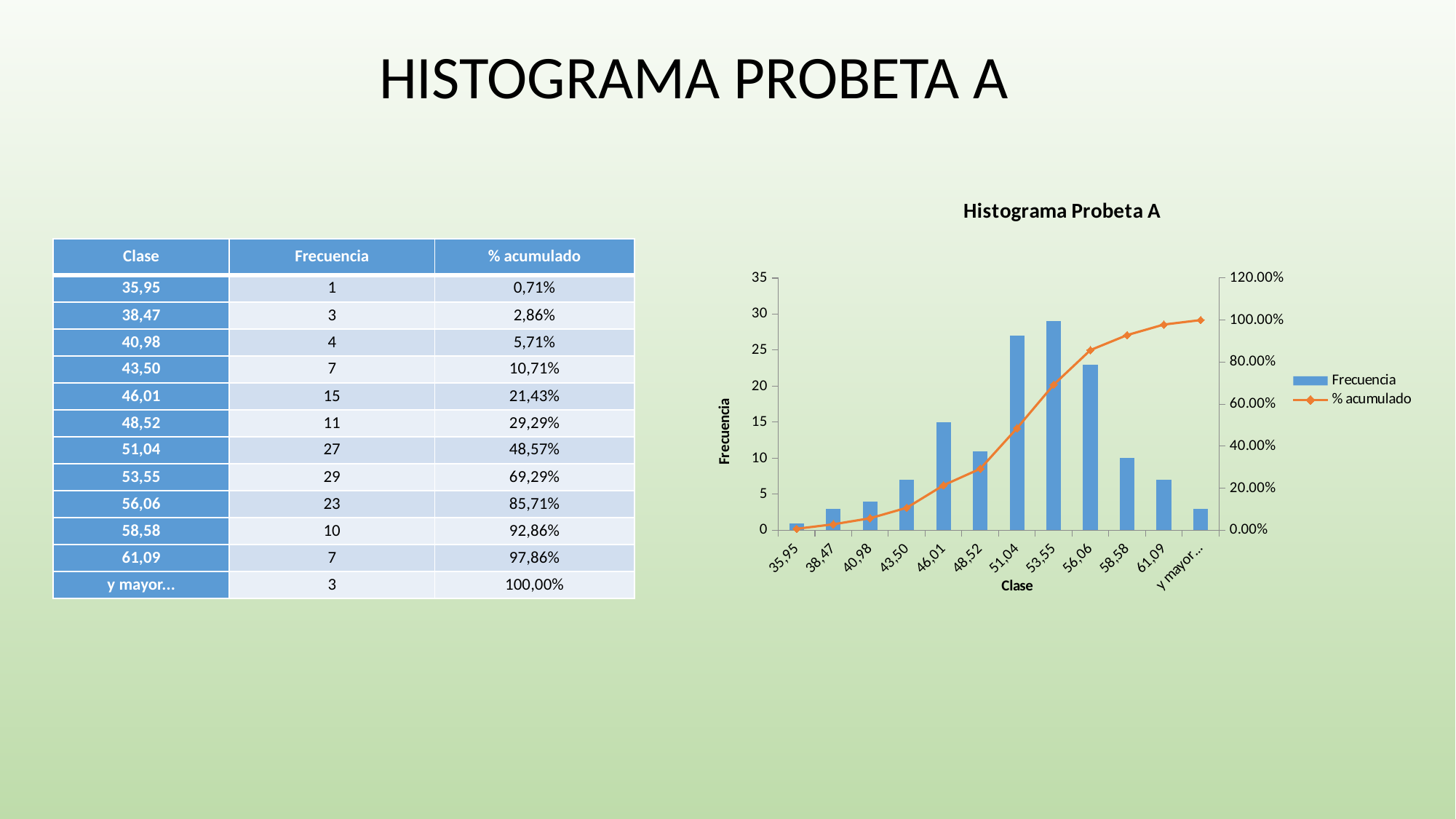
Does the % acumulado line rise or fall from left to right along the x axis? rises What kind of chart is shown on the slide? bar chart with a line Which class has the lowest Frecuencia bar? 35,95 Which class has the taller Frecuencia bar, 46,01 or 48,52? 46,01 What is the Frecuencia for class 51,04? 27 How many series does the chart legend list? 2 What is the % acumulado for class 56,06? 85,71% Is the Frecuencia bar for class 46,01 greater or less than 10? greater Which class has the highest Frecuencia bar? 53,55 What is the difference in Frecuencia between class 53,55 and class 51,04? 2 Is the Frecuencia bar for class 58,58 greater or less than 15? less How many classes (categories) are plotted along the x axis of the chart? 12